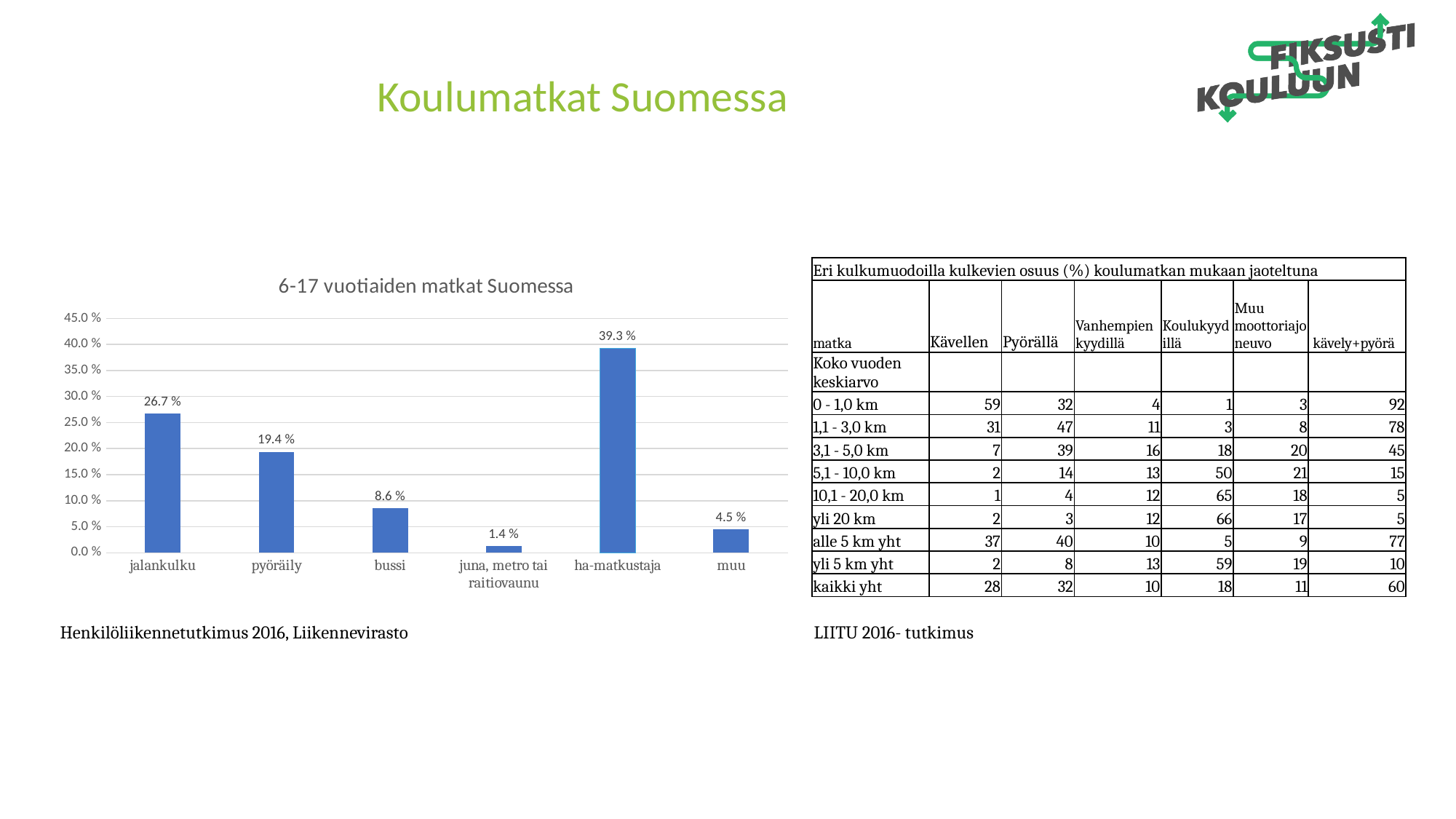
What is the value for ha-matkustaja in the chart? 39.3 % What kind of chart is shown on the slide? bar chart What is the value for juna, metro tai raitiovaunu in the chart? 1.4 % Which category has the highest value in the chart? ha-matkustaja Which is larger, the value for pyöräily or the value for bussi? pyöräily What is the title of the chart on the slide? 6-17 vuotiaiden matkat Suomessa Is the value for muu greater or less than 5.0 %? less What is the value for bussi in the chart? 8.6 % What is the difference between the values for ha-matkustaja and jalankulku? 12.6 % What is the value for jalankulku in the chart "6-17 vuotiaiden matkat Suomessa"? 26.7 % Which category has the lowest value in the chart? juna, metro tai raitiovaunu How many categories are shown in the chart? 6